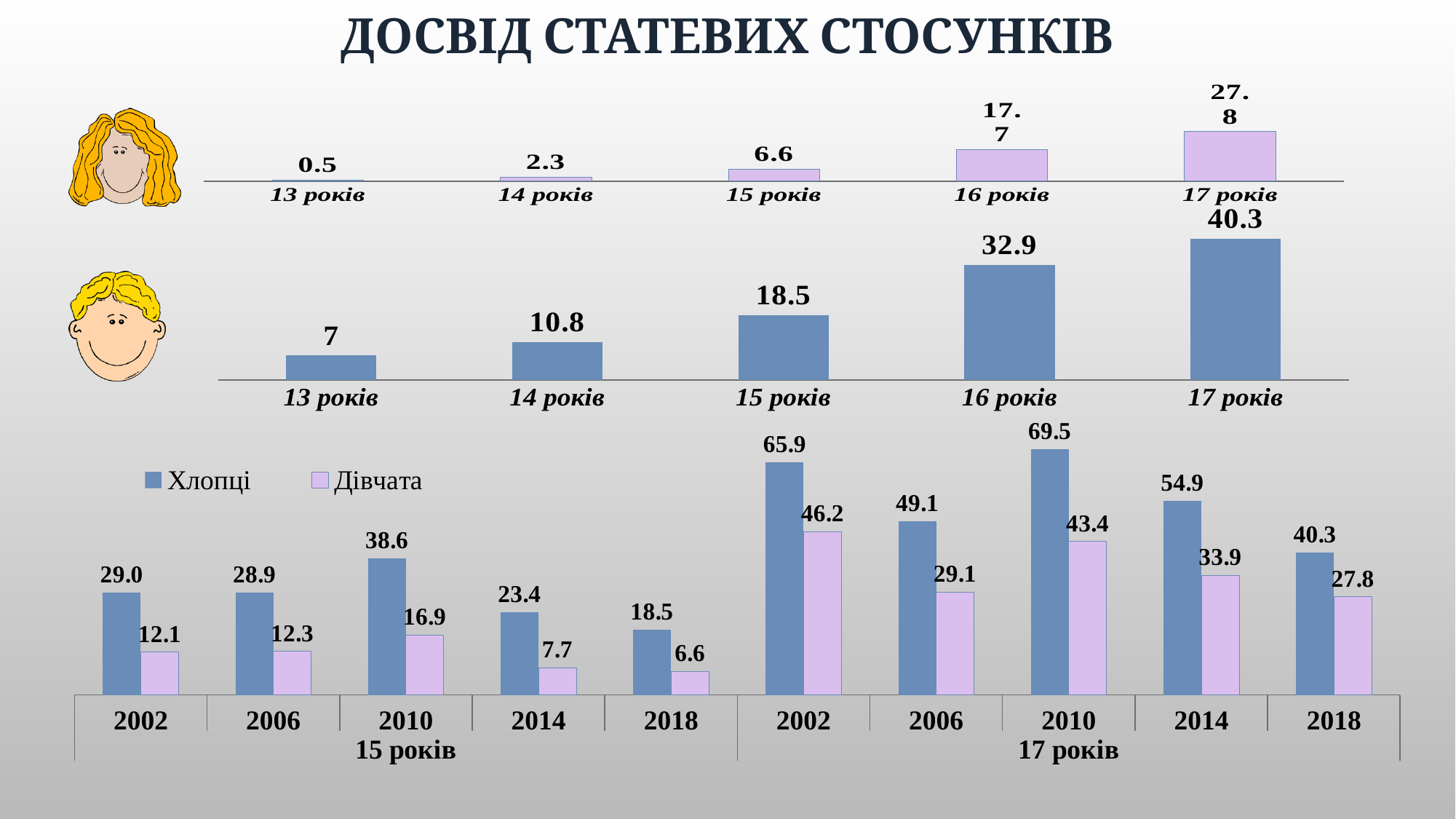
In the middle chart (next to the boy icon), what is the difference between the values for 17 років and 16 років? 7.4 In the bottom chart, how many series does the legend list? 2 In the middle chart (next to the boy icon), which age group has the lowest value? 13 років In the bottom chart, what is the value for Хлопці in 2010 in the 17 років group? 69.5 What type of chart is the bottom chart? bar chart In the bottom chart, which is larger: Хлопці in 2002 for 15 років or Хлопці in 2006 for 17 років? Хлопці in 2006 for 17 років In the middle chart (next to the boy icon), what is the value for 14 років? 10.8 In the top chart (next to the girl icon), what is the value for 15 років? 6.6 In the bottom chart, what is the value for Дівчата in 2014 in the 15 років group? 7.7 In the middle chart (next to the boy icon), do the values rise or fall as age increases from 13 років to 17 років? rise In the bottom chart, what is the difference between Хлопці and Дівчата in 2018 in the 17 років group? 12.5 In the top chart (next to the girl icon), which age group has the highest value? 17 років